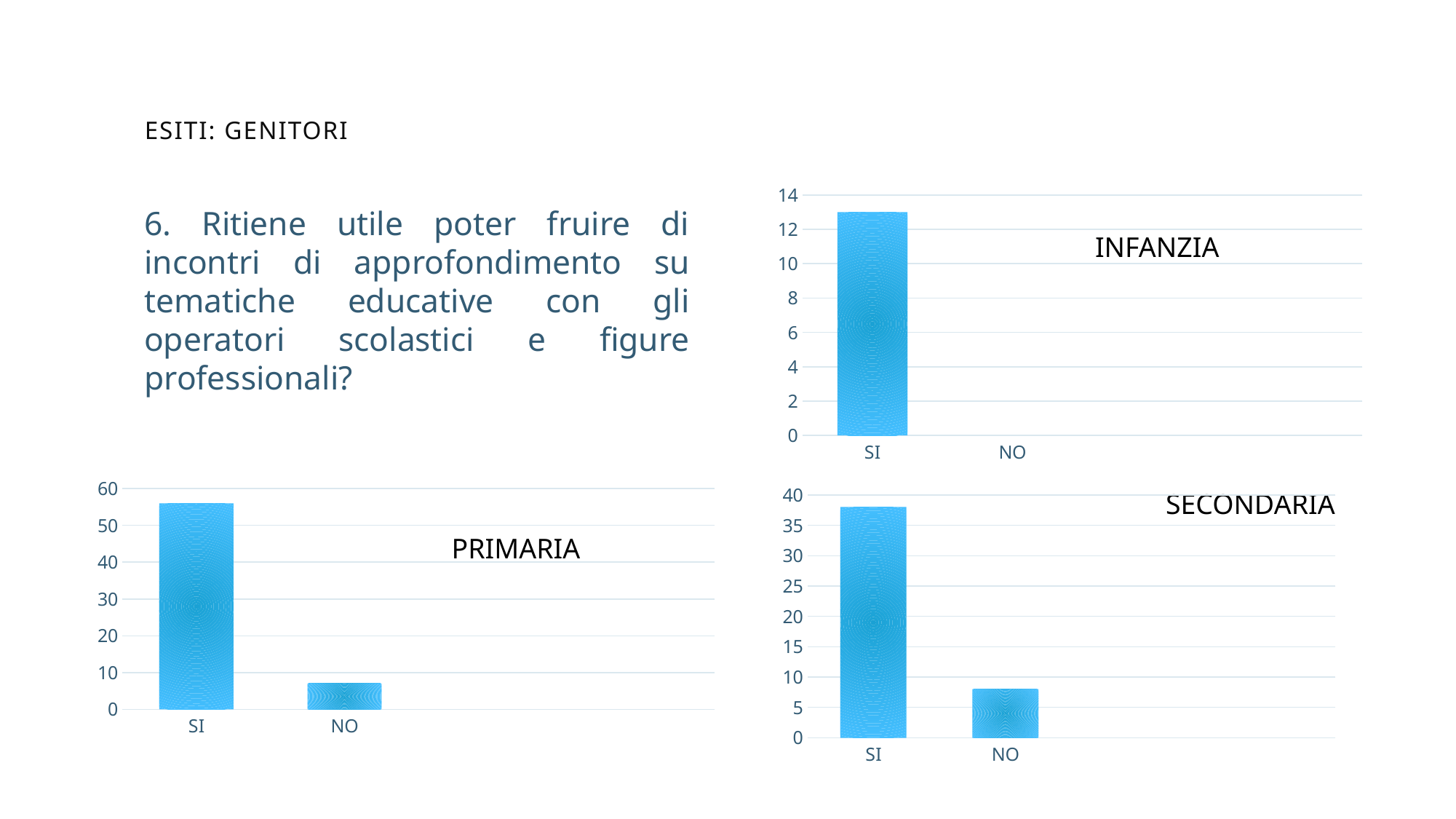
In the PRIMARIA chart, is the value for NO greater or less than 10? less In the PRIMARIA chart, which category has the lowest value? NO How many charts are shown on the slide? 3 In the SECONDARIA chart, is the value for SI greater or less than 35? greater What kind of chart is the SECONDARIA chart? bar chart In the INFANZIA chart, which category has the highest value? SI In the INFANZIA chart, is the value for SI greater or less than 14? less How many categories are shown on the x axis of the PRIMARIA chart? 2 In the SECONDARIA chart, which is larger, SI or NO? SI